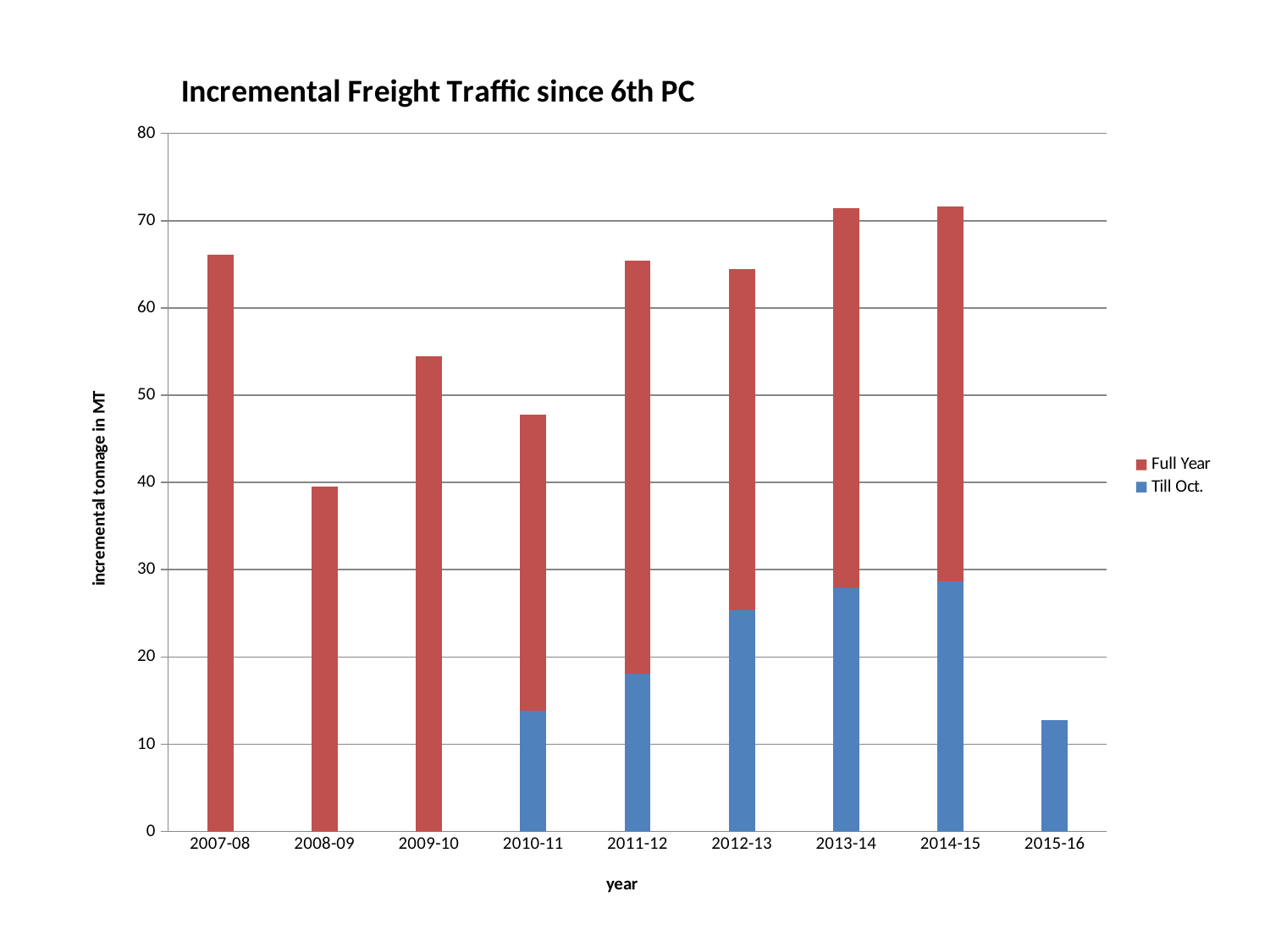
What kind of chart is shown on the slide? bar chart Is the bar for 2015-16 greater or less than 20? less Which year has the taller total bar, 2007-08 or 2008-09? 2007-08 Is the total bar height for 2010-11 greater or less than 50? less Which year has the lowest total bar height? 2015-16 What is the label on the vertical axis of the chart? incremental tonnage in MT How many years are shown on the x axis of the chart? 9 Is the total bar height for 2007-08 greater or less than 60? greater What is the title of the chart? Incremental Freight Traffic since 6th PC How many series does the legend list? 2